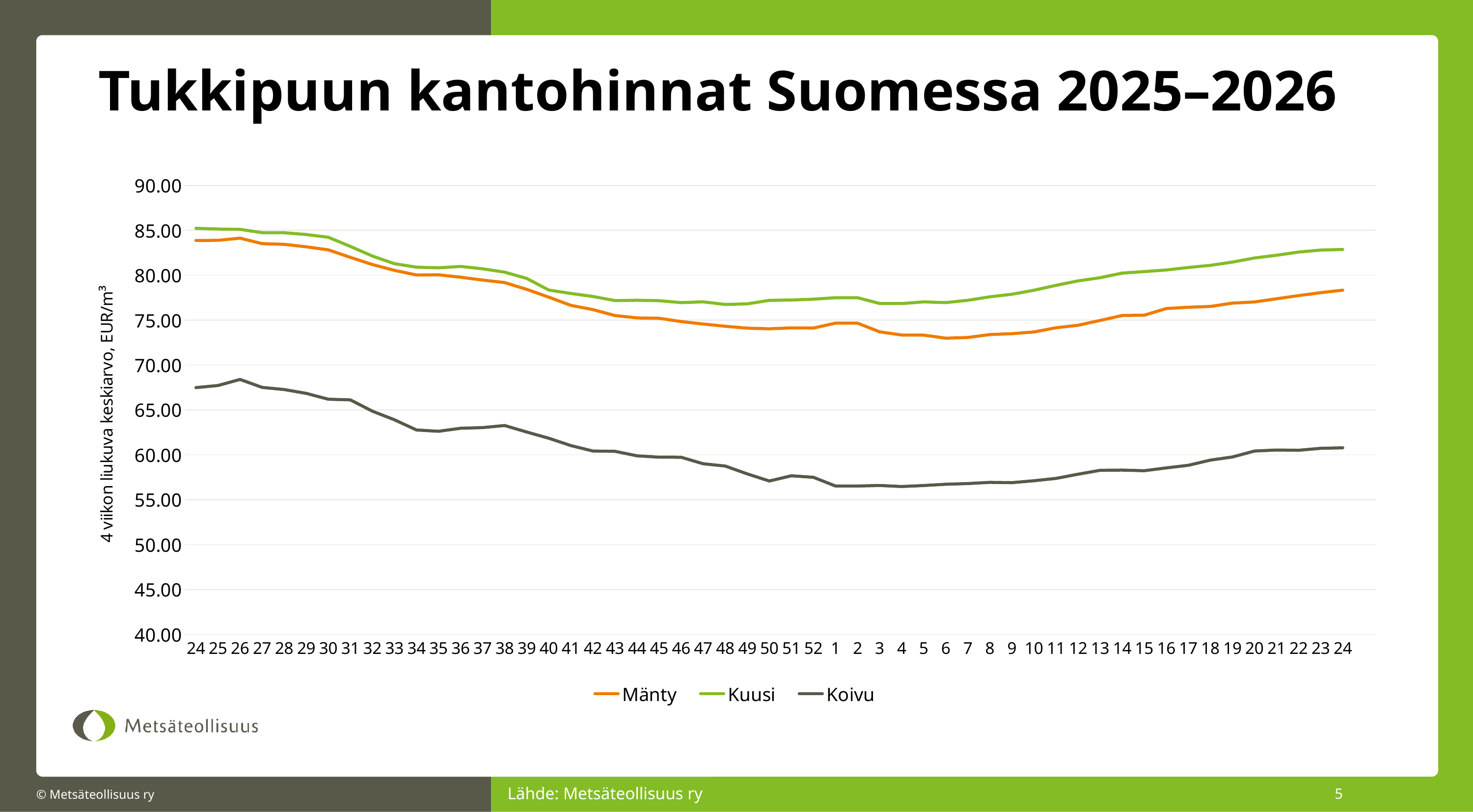
Is the value for Koivu at week 1 greater or less than 60.00? less Which series has the highest values across the whole period? Kuusi Is the value for Koivu at week 24 (the first point) greater or less than 65.00? greater How many series does the legend list? 3 Does the Koivu line rise or fall from week 24 to week 1? fall What kind of chart is shown on the slide? line chart Is the value for Kuusi at the last point (week 24) greater or less than 80.00? greater Which series has the lowest values across the whole period? Koivu What is the title of the chart? Tukkipuun kantohinnat Suomessa 2025–2026 At week 40, which is larger, the value for Kuusi or the value for Mänty? Kuusi Which series is plotted with the orange line? Mänty